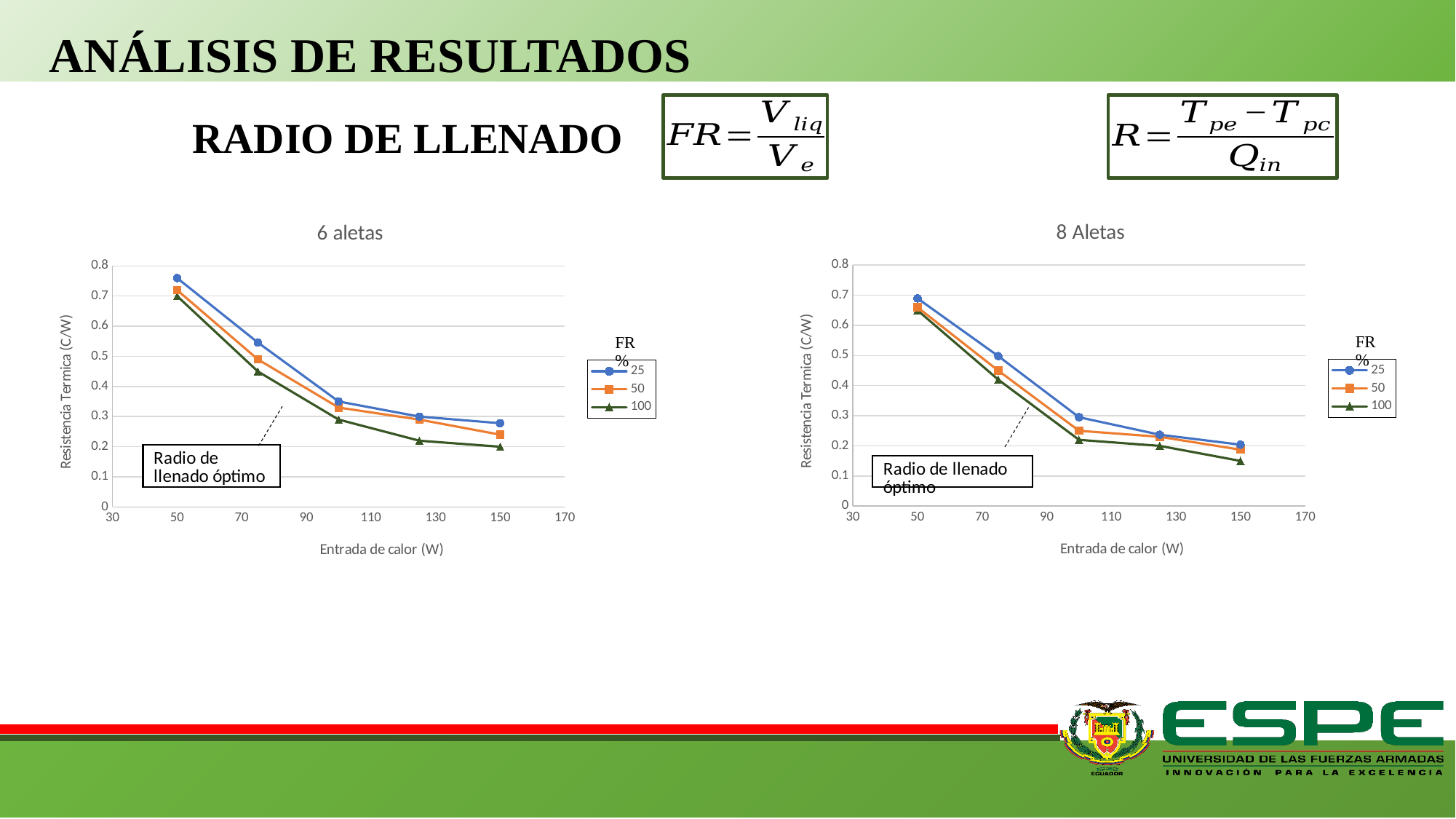
How many series does the legend of the "8 Aletas" chart list? 3 In the "8 Aletas" chart, does the thermal resistance for the 50 series rise or fall as heat input increases? fall In the "6 aletas" chart, is the value for the 25 series at 75 W greater or less than 0.5? greater In the "8 Aletas" chart, is the value for the 50 series at 75 W greater or less than 0.4? greater In the "8 Aletas" chart, which series has the lowest value at 150 W? 100 In the "6 aletas" chart, is the value for the 25 series at 50 W greater or less than 0.7? greater In the "6 aletas" chart, at 50 W, which is larger: the value for the 25 series or the 100 series? 25 In the "6 aletas" chart, which series has the highest value at 150 W? 25 What kind of chart is the "6 aletas" chart? line chart What is the x-axis label of the "8 Aletas" chart? Entrada de calor (W) In the "6 aletas" chart, how many data points does the 25 series have? 5